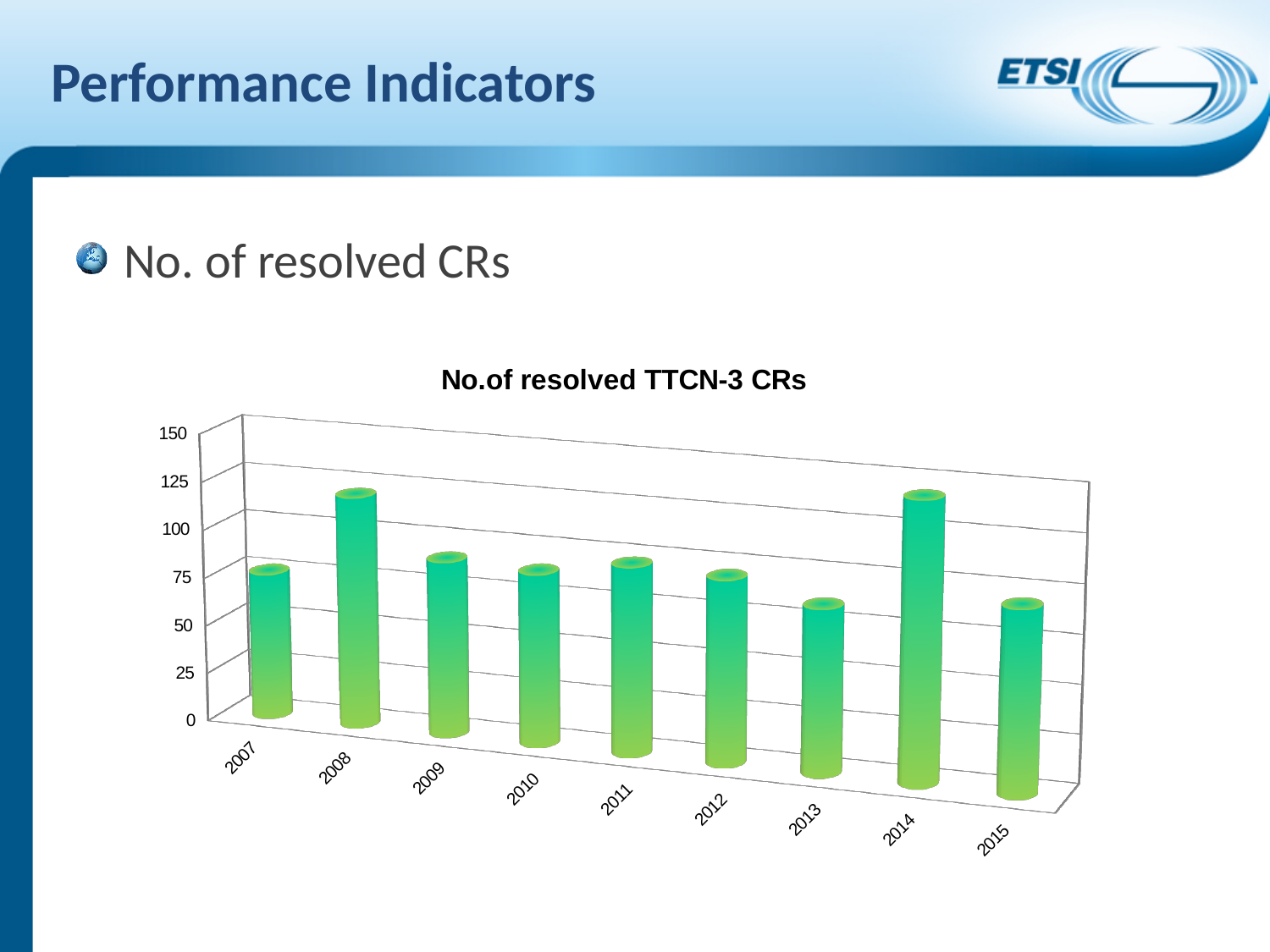
Is the value for 2014 greater or less than 100? greater Is the value for 2009 greater or less than 50? greater Is the value for 2008 greater or less than 100? greater What is the title of the chart? No.of resolved TTCN-3 CRs Which year has the larger value, 2007 or 2014? 2014 What kind of chart is shown on the slide? bar chart Which year has the larger value, 2014 or 2015? 2014 How many years are shown on the x axis of the chart? 9 Which year has the larger value, 2008 or 2013? 2008